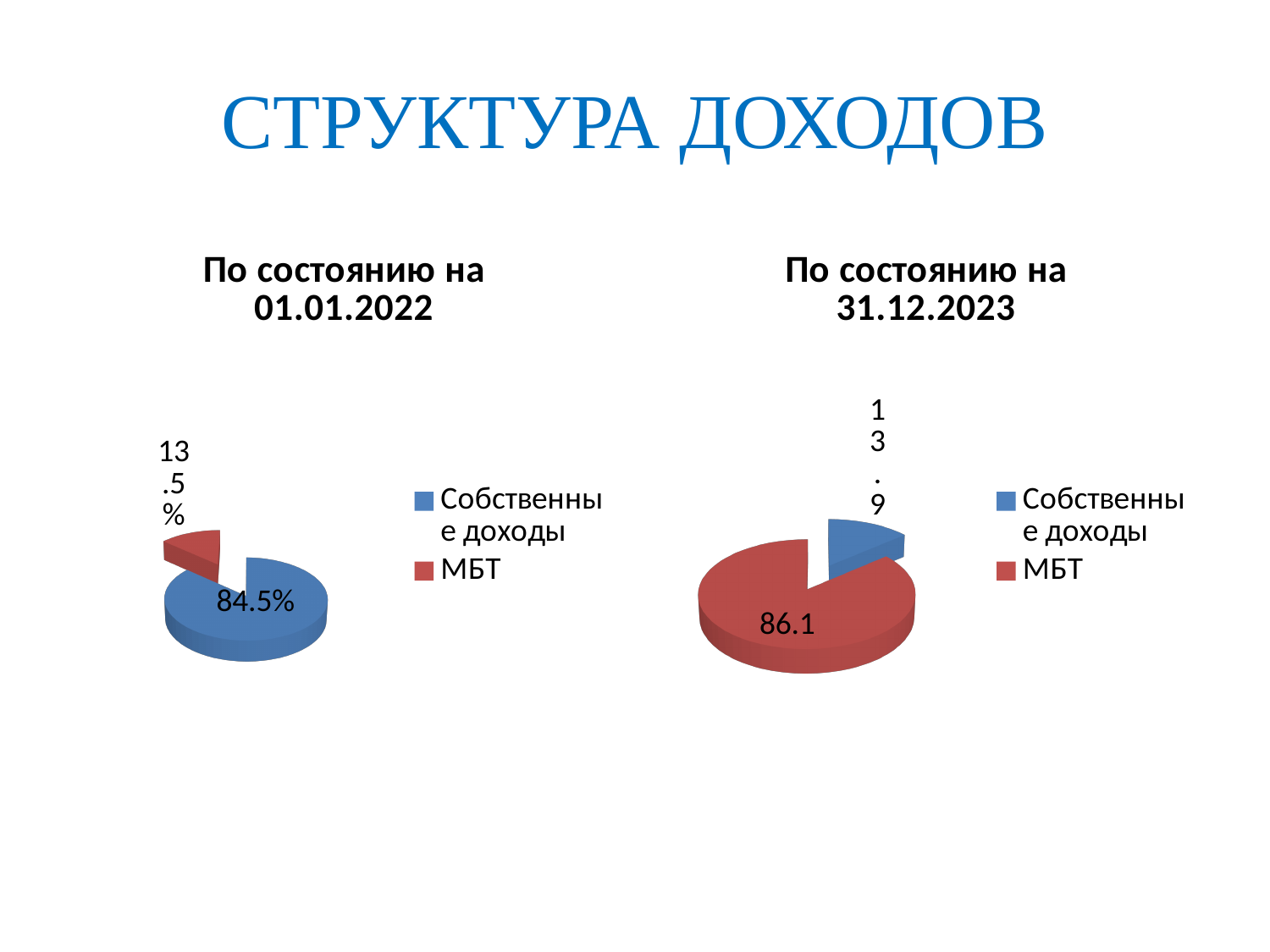
In the chart titled 'По состоянию на 31.12.2023', what is the value shown for Собственные доходы? 13.9 What type of chart is the one titled 'По состоянию на 31.12.2023'? Pie chart How many slices does the chart titled 'По состоянию на 01.01.2022' have? 2 How many entries does the legend of the chart titled 'По состоянию на 31.12.2023' list? 2 In the chart titled 'По состоянию на 01.01.2022', which category has the largest slice? Собственные доходы In the chart titled 'По состоянию на 31.12.2023', which category has the smallest slice? Собственные доходы In the chart titled 'По состоянию на 31.12.2023', what is the value shown for МБТ? 86.1 In the chart titled 'По состоянию на 01.01.2022', what is the value shown for Собственные доходы? 84.5% In the chart titled 'По состоянию на 31.12.2023', which category has the largest slice? МБТ In the chart titled 'По состоянию на 01.01.2022', what colour is the МБТ slice? Red In the chart titled 'По состоянию на 01.01.2022', what is the value shown for МБТ? 13.5% In the chart titled 'По состоянию на 01.01.2022', which is larger: Собственные доходы or МБТ? Собственные доходы